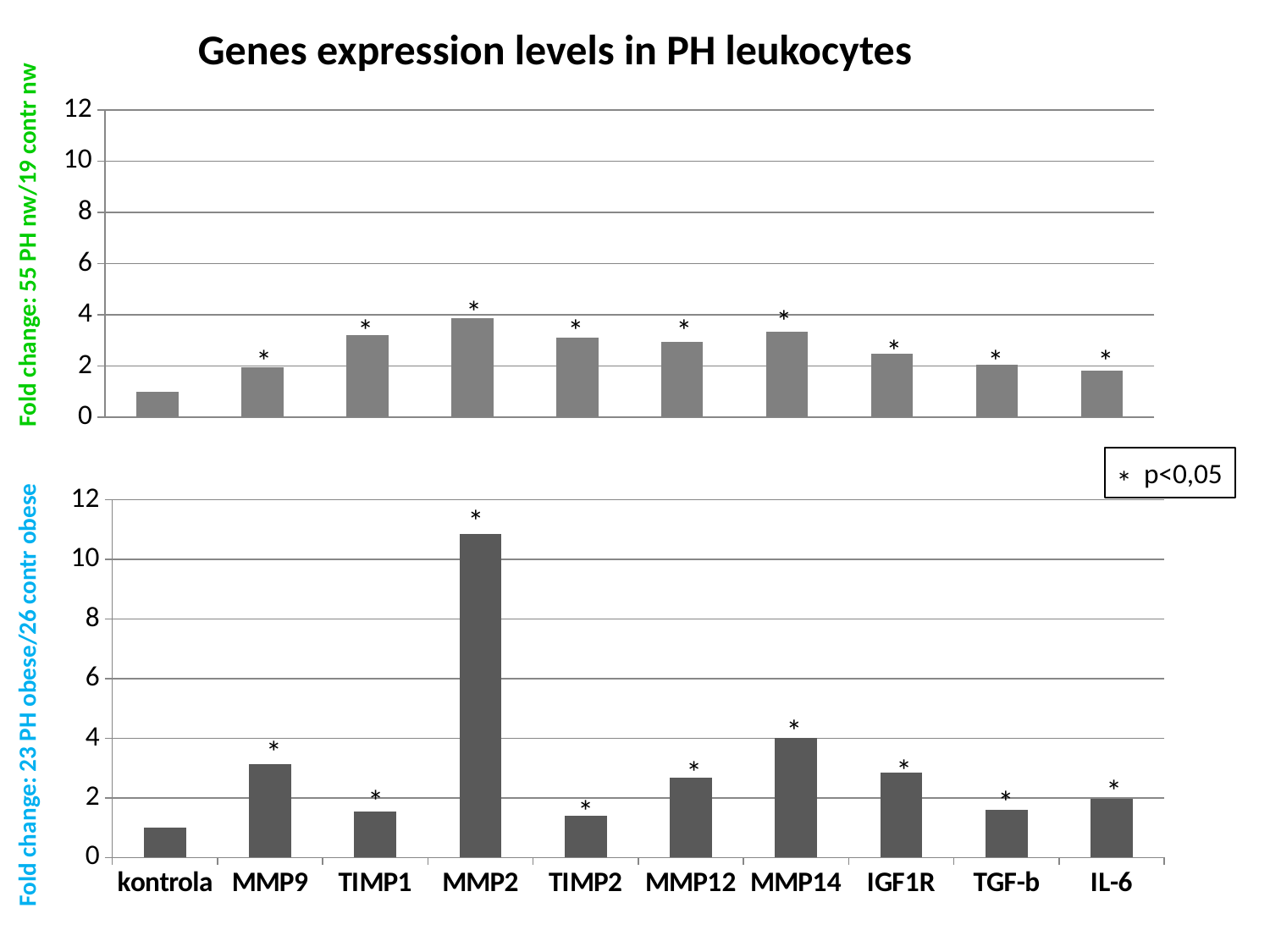
In the top chart (Fold change: 55 PH nw/19 contr nw), which category has the highest bar? MMP2 In the top chart, is the value for TIMP1 greater or less than 2? greater In the bottom chart, is the value for MMP2 greater or less than 10? greater How many gene categories are shown along the x axis of the bottom chart? 10 What is the title shown above the charts on the slide? Genes expression levels in PH leukocytes In the bottom chart, which category has the lowest bar? kontrola What kind of chart is the top chart on the slide? bar chart According to the legend box on the slide, what does the asterisk (*) above the bars indicate? p<0,05 In the bottom chart, which is larger, the value for MMP9 or the value for TIMP1? MMP9 In the bottom chart (Fold change: 23 PH obese/26 contr obese), which category has the highest bar? MMP2 In the bottom chart, is the value for MMP9 greater or less than 2? greater